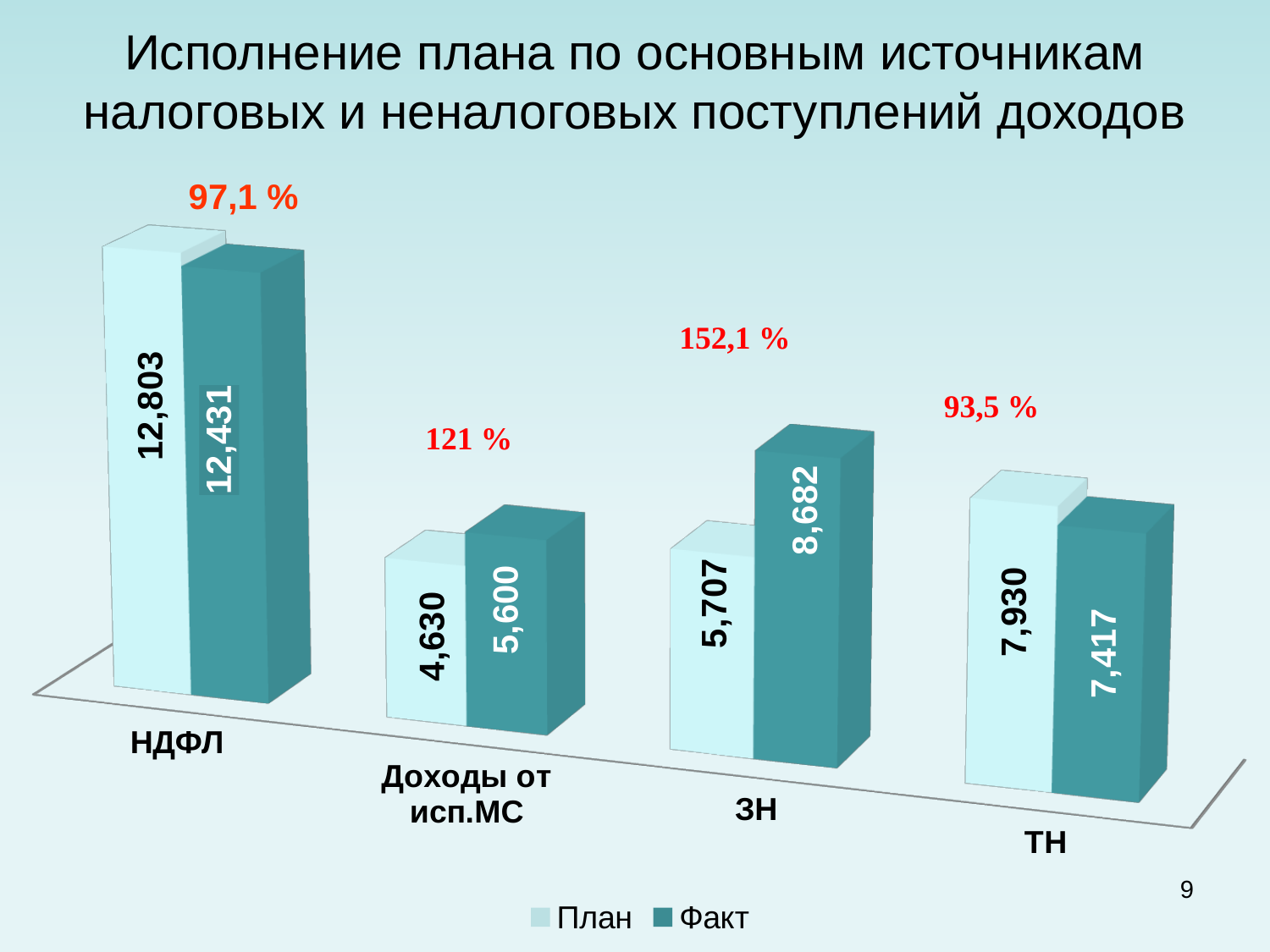
What is the Факт value for Доходы от исп.МС? 5,600 What is the difference between the Факт and План values for ЗН? 2,975 What is the difference between the План and Факт values for ТН? 513 What percentage label is shown above the ЗН bars? 152,1 % What is the Факт value for ЗН? 8,682 What is the План value for ТН? 7,930 How many series does the legend list? 2 Which category has the lowest План value? Доходы от исп.МС What is the План value for НДФЛ? 12,803 Which category has the highest Факт value? НДФЛ How many categories are shown on the x axis? 4 For Доходы от исп.МС, which is larger, the План value or the Факт value? Факт